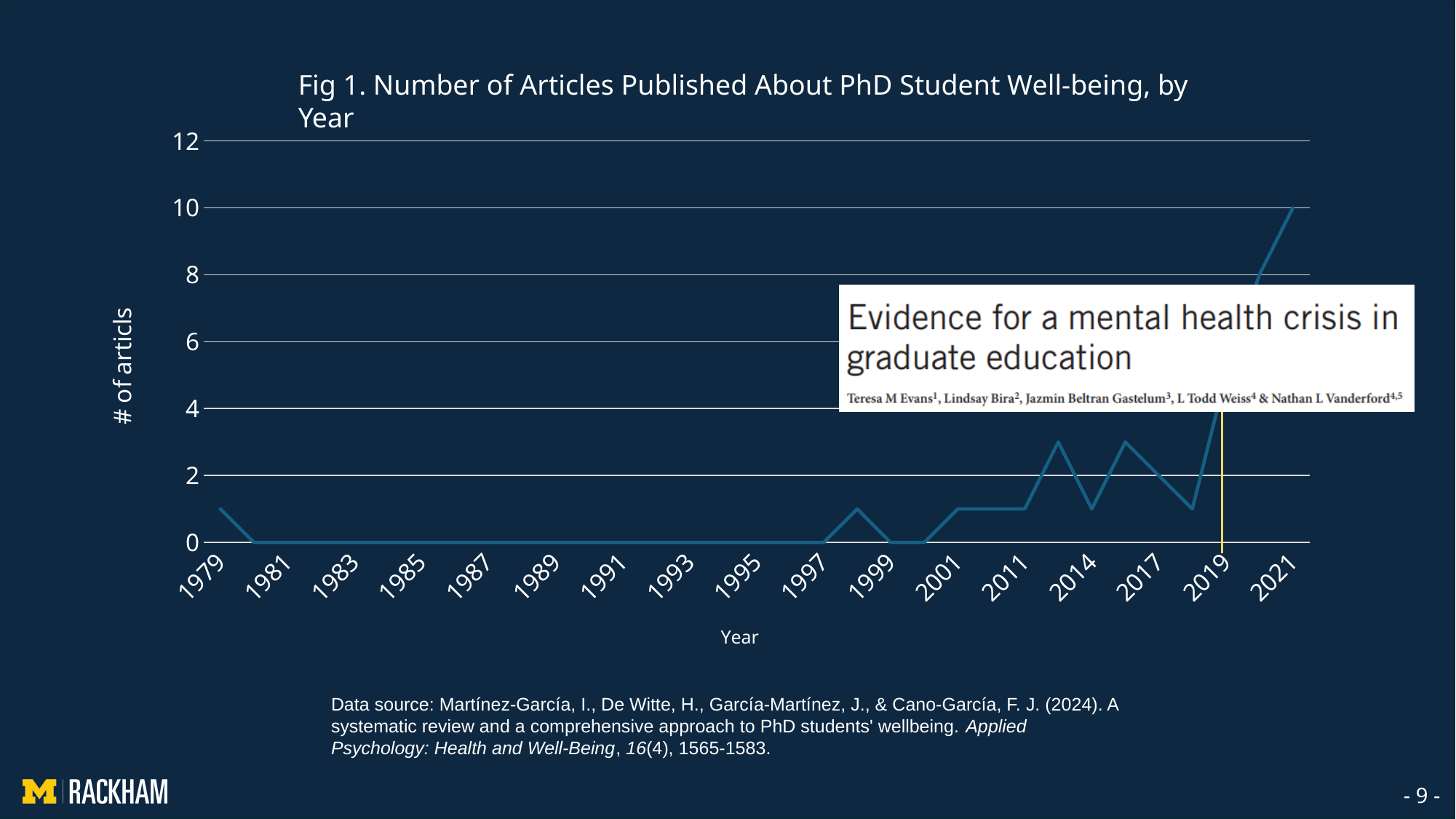
Is the value for 1979 greater or less than 2? less How many articles were published in 2017? 2 What is the title of the chart? Fig 1. Number of Articles Published About PhD Student Well-being, by Year What is the difference between the number of articles in 2021 and in 2017? 8 What kind of chart is shown on the slide? line chart Does the number of articles rise or fall between 2019 and 2021? rise How many articles were published in 1981? 0 What is the label on the x axis of the chart? Year Which year has the highest number of articles? 2021 Which year has more articles, 2021 or 2017? 2021 How many articles were published in 2021? 10 Is the value for 2019 greater or less than 2? greater